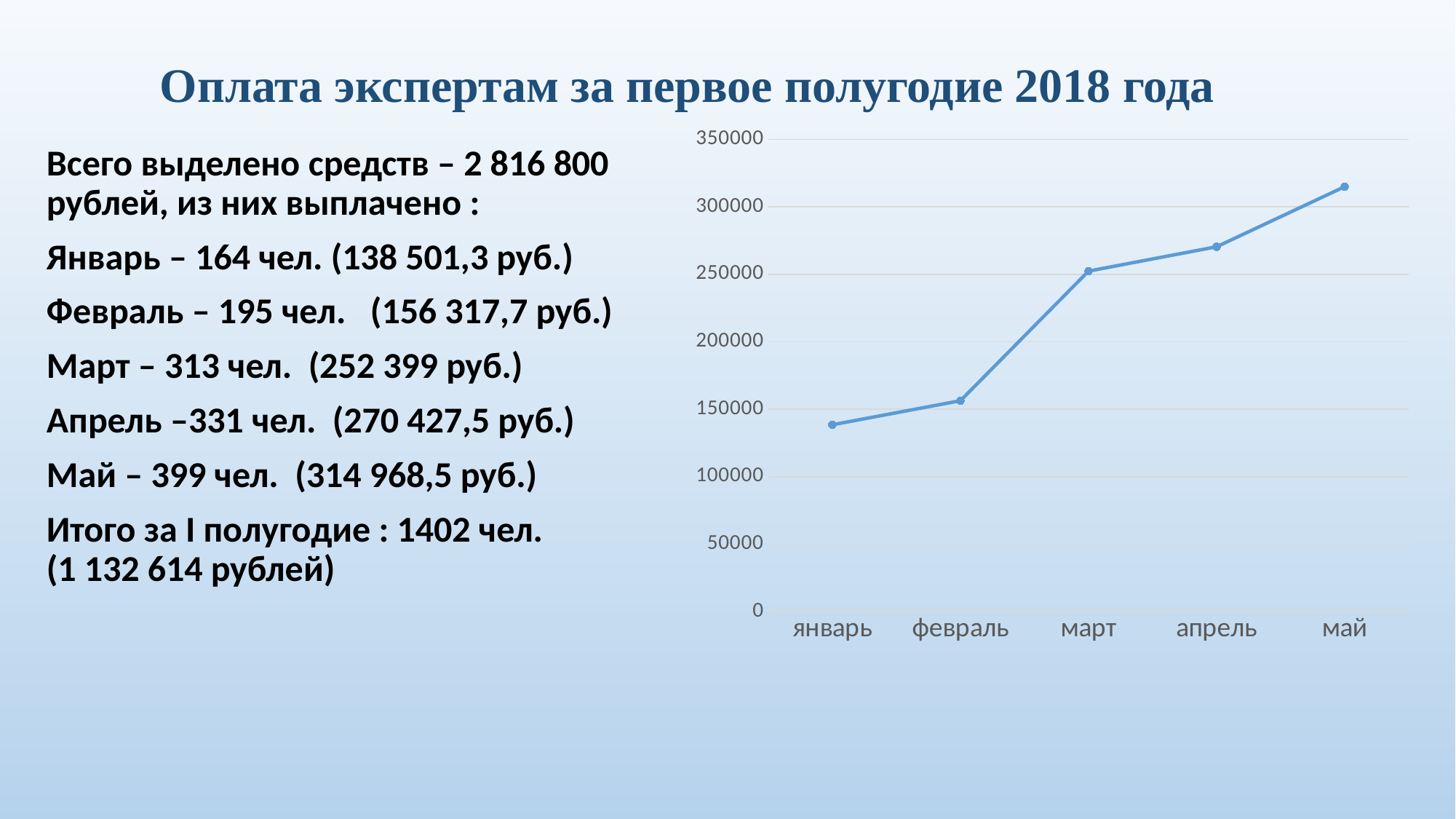
How many months are plotted on the x axis of the chart? 5 What is the title of the slide containing the chart? Оплата экспертам за первое полугодие 2018 года Is the value for январь greater or less than 150000? less What kind of chart is shown on the slide? line chart Is the value for март greater or less than 200000? greater Do the values on the chart rise or fall from январь to май? rise Is the value for февраль greater or less than 150000? greater Which month has the highest value on the chart? май Which is larger on the chart, the value for март or the value for февраль? март Which month has the lowest value on the chart? январь